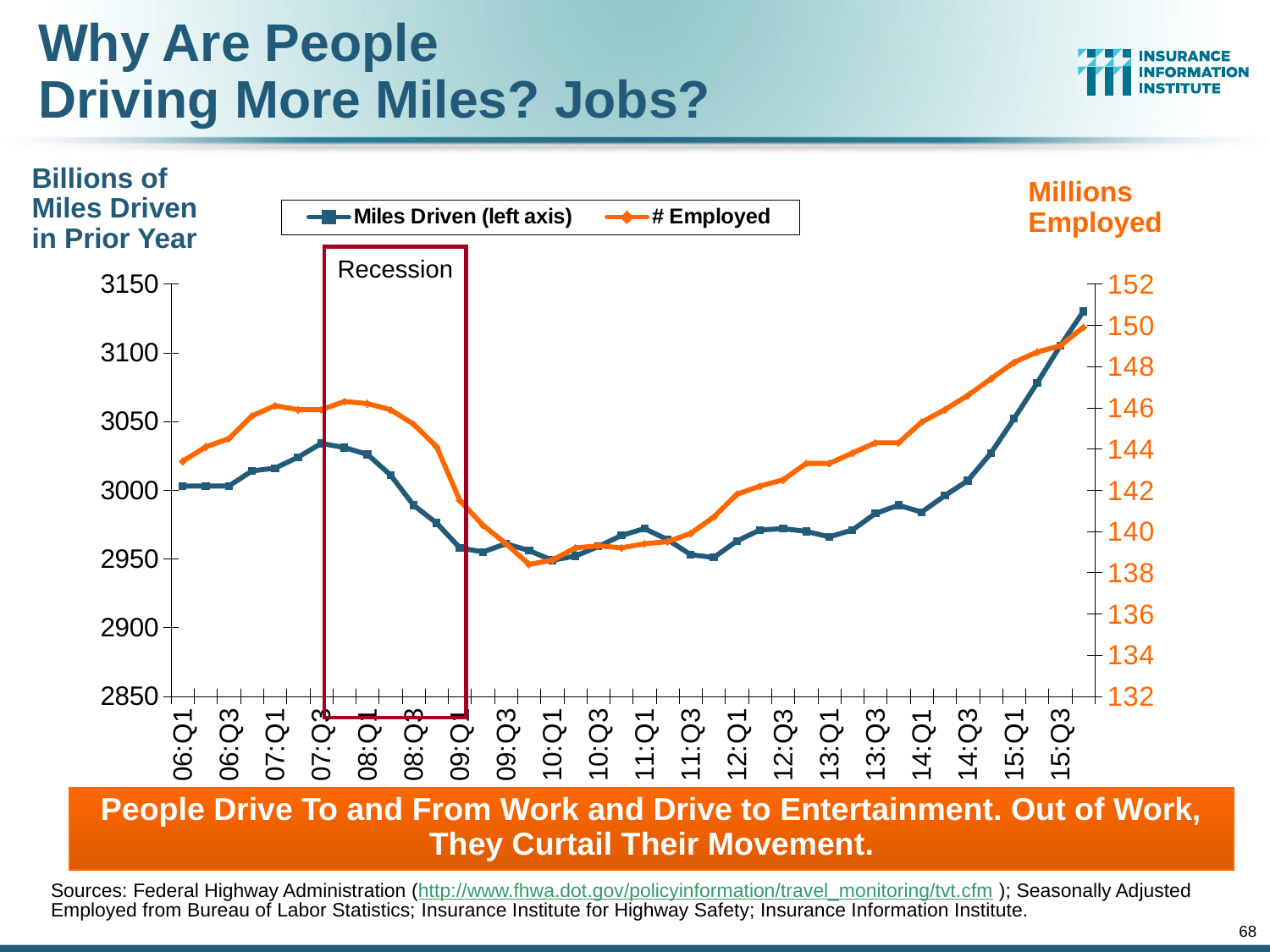
What are the two series named in the legend? Miles Driven (left axis) and # Employed Is the value for # Employed at 09:Q3 greater or less than 140? less Is the value for Miles Driven at 09:Q3 greater or less than 3000? less Is the value for Miles Driven at 15:Q3 greater or less than 3100? greater What kind of chart is shown on the slide? Line chart Does the # Employed series rise or fall between 07:Q3 and 09:Q3? Fall Does the Miles Driven series rise or fall between 13:Q1 and 15:Q3? Rise How many series does the legend list? 2 What is the label on the right-hand axis of the chart? Millions Employed